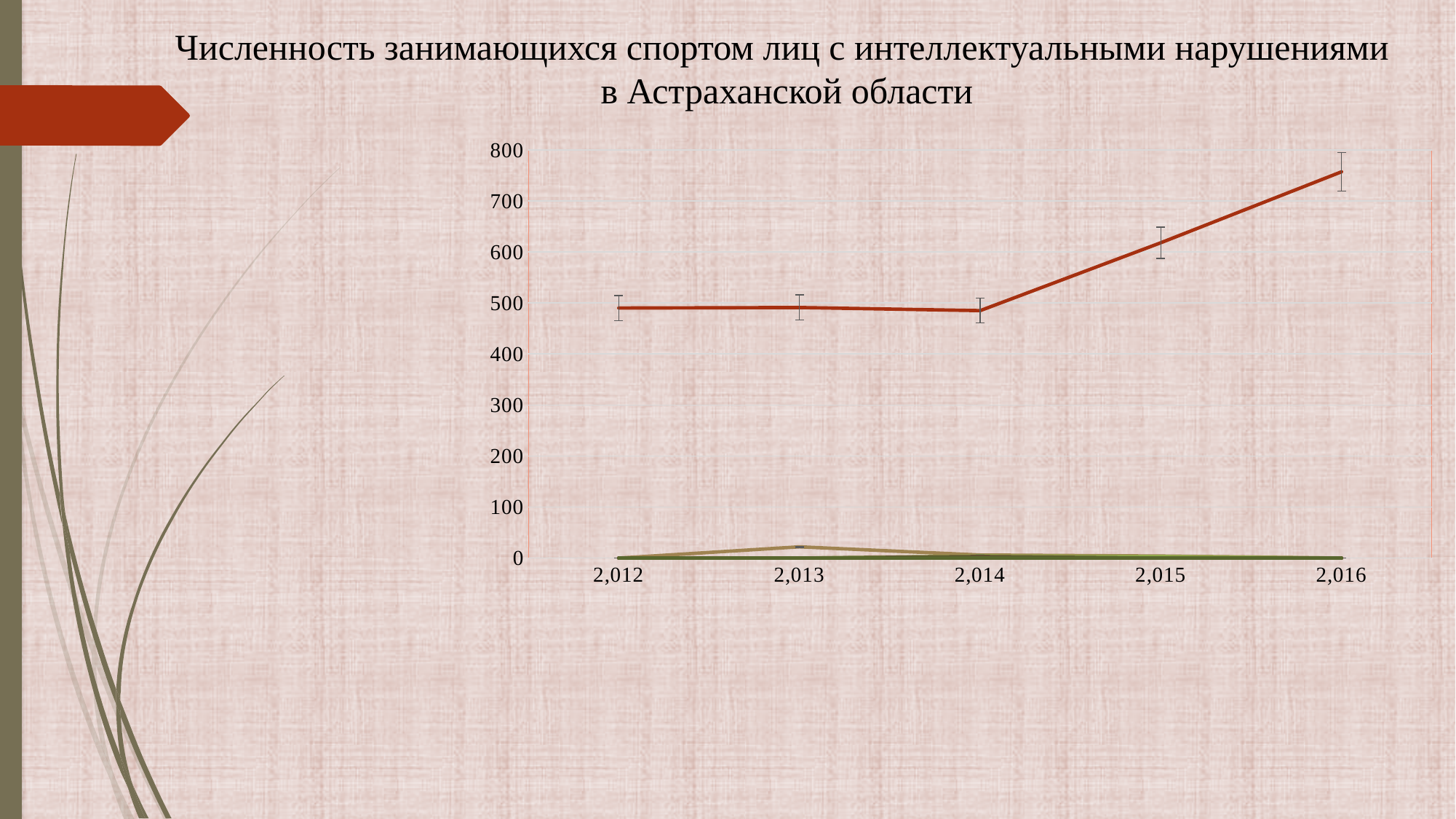
In which year does the red line reach its highest value? 2,016 What kind of chart is shown on the slide? line chart Does the red line rise or fall between 2,014 and 2,016? rise What is the highest value shown on the y axis? 800 Is the value of the red line in 2,016 greater or less than 700? greater Is the value of the red line in 2,014 greater or less than 400? greater Which is larger for the red line: the value in 2,015 or the value in 2,016? 2,016 Is the value of the red line in 2,012 greater or less than 600? less What is the first year shown on the x axis? 2,012 What is the last year shown on the x axis? 2,016 How many years are shown along the x axis? 5